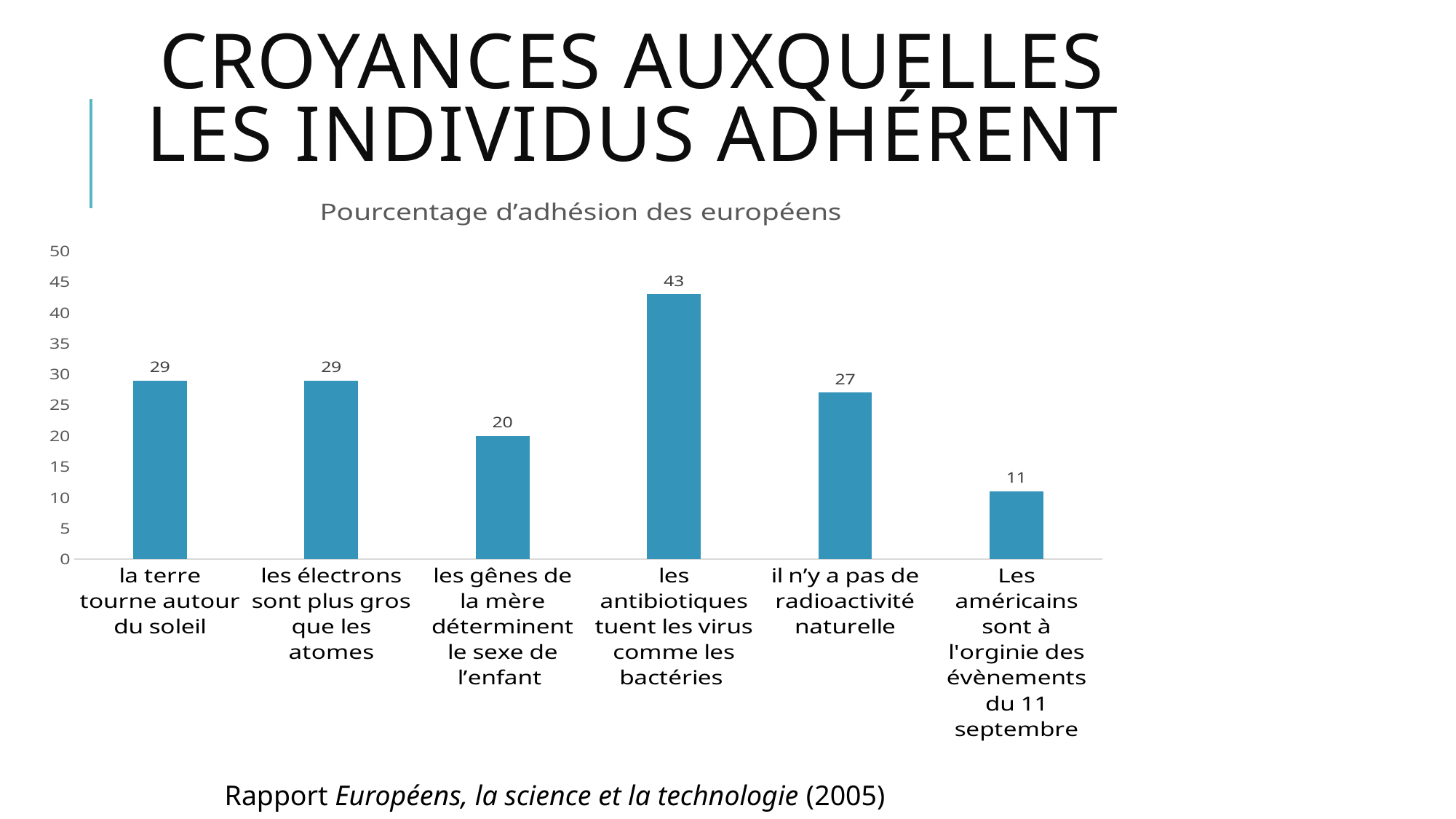
What is the difference between the value for "les électrons sont plus gros que les atomes" and the value for "les gênes de la mère déterminent le sexe de l'enfant"? 9 How many categories are shown in the chart? 6 Which category has the highest value? les antibiotiques tuent les virus comme les bactéries Which category has the lowest value? Les américains sont à l'orginie des évènements du 11 septembre What is the difference between the value for "les antibiotiques tuent les virus comme les bactéries" and the value for "Les américains sont à l'orginie des évènements du 11 septembre"? 32 Is the value for "les antibiotiques tuent les virus comme les bactéries" greater or less than 40? greater What is the value for "il n'y a pas de radioactivité naturelle"? 27 What is the title of the chart? Pourcentage d'adhésion des européens What is the value for "les gênes de la mère déterminent le sexe de l'enfant"? 20 What kind of chart is shown on the slide? bar chart What is the value for "les antibiotiques tuent les virus comme les bactéries"? 43 Which is larger: the value for "la terre tourne autour du soleil" or the value for "il n'y a pas de radioactivité naturelle"? la terre tourne autour du soleil